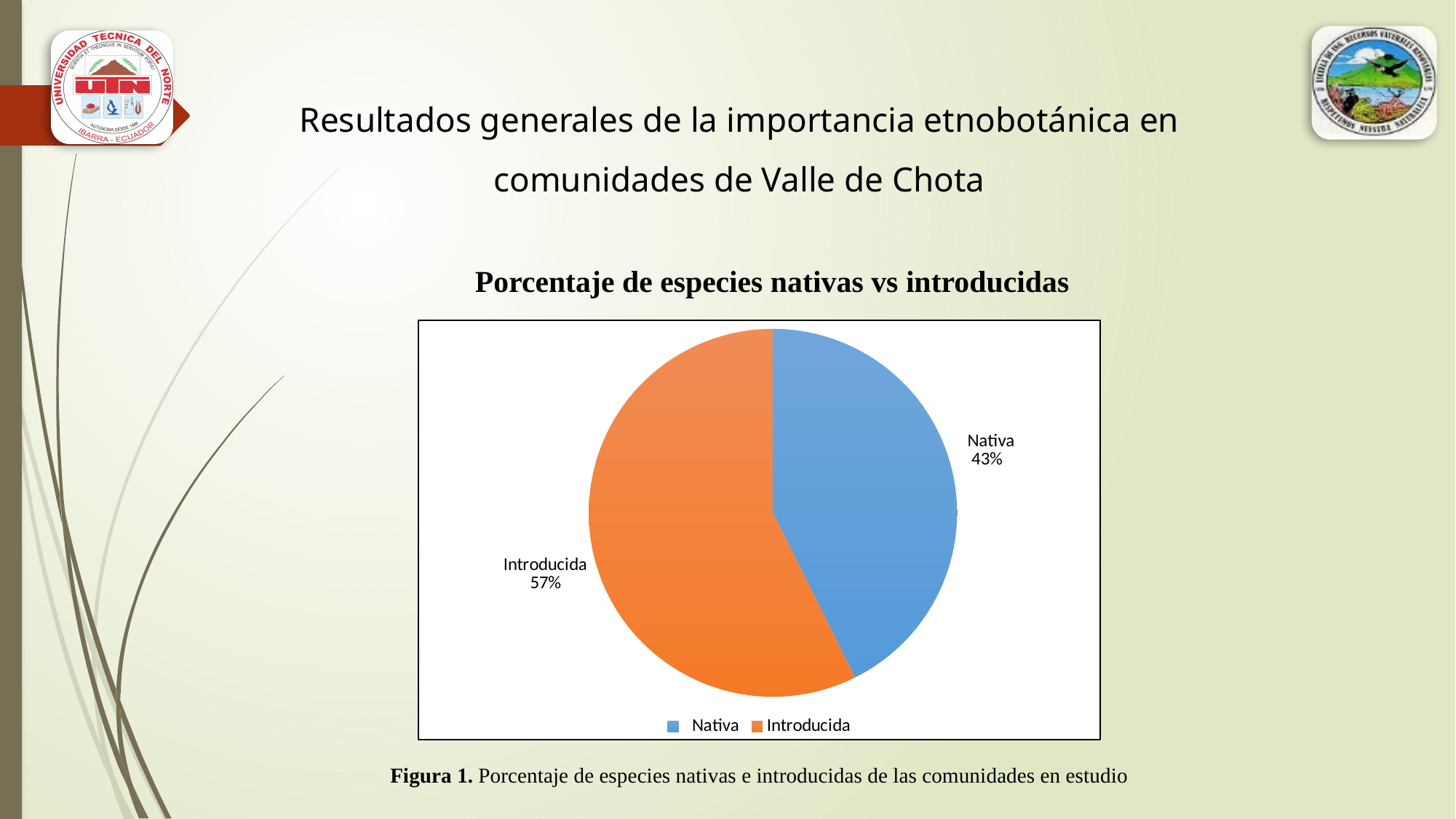
Which category has the smallest share of the pie? Nativa How many slices does the pie chart have? 2 What colour is the Introducida slice? orange How many entries does the legend list? 2 What percentage of species are Nativa? 43% What is the title of the chart? Porcentaje de especies nativas vs introducidas What percentage of species are Introducida? 57% What kind of chart is shown on the slide? pie chart Which is larger, the share for Nativa or the share for Introducida? Introducida Which category has the largest share of the pie? Introducida What share of the pie does the Nativa slice represent? 43% What is the difference in percentage points between Introducida and Nativa? 14